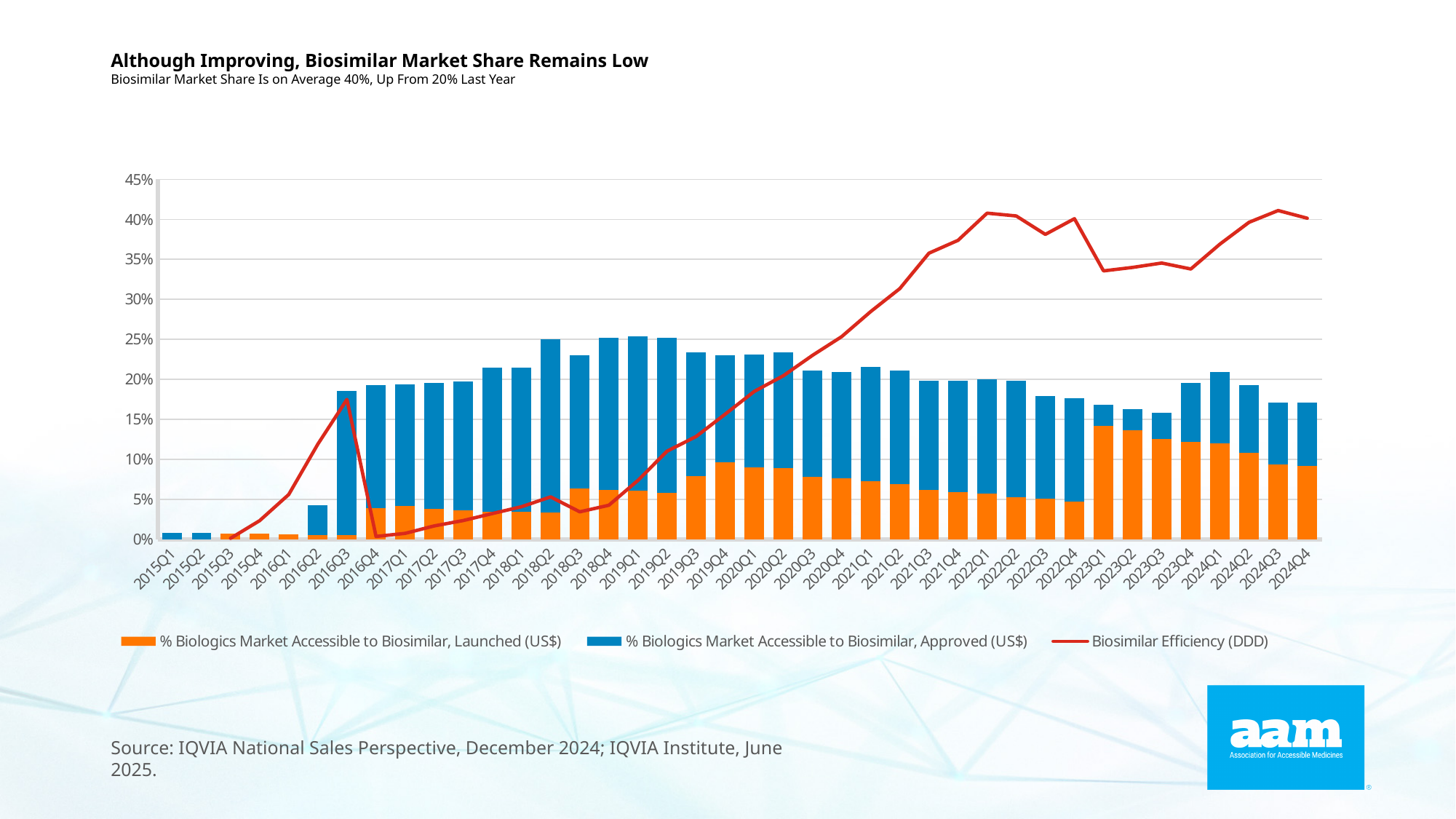
Which colour represents % Biologics Market Accessible to Biosimilar, Approved (US$) in the legend? Blue How many quarters are shown along the x axis? 40 Which quarter has the larger % Biologics Market Accessible to Biosimilar, Launched (US$) value, 2019Q1 or 2023Q1? 2023Q1 Is the Biosimilar Efficiency (DDD) value for 2023Q1 greater or less than 35%? less Does the Biosimilar Efficiency (DDD) line generally rise or fall from 2016Q4 to 2022Q1? rise Is the Biosimilar Efficiency (DDD) value for 2018Q3 greater or less than 5%? less What kind of chart is shown on the slide? A combination chart with stacked bars and a line Is the Biosimilar Efficiency (DDD) value for 2021Q1 greater or less than 25%? greater Which has the taller stacked bar, 2018Q2 or 2022Q3? 2018Q2 How many series does the legend list? 3